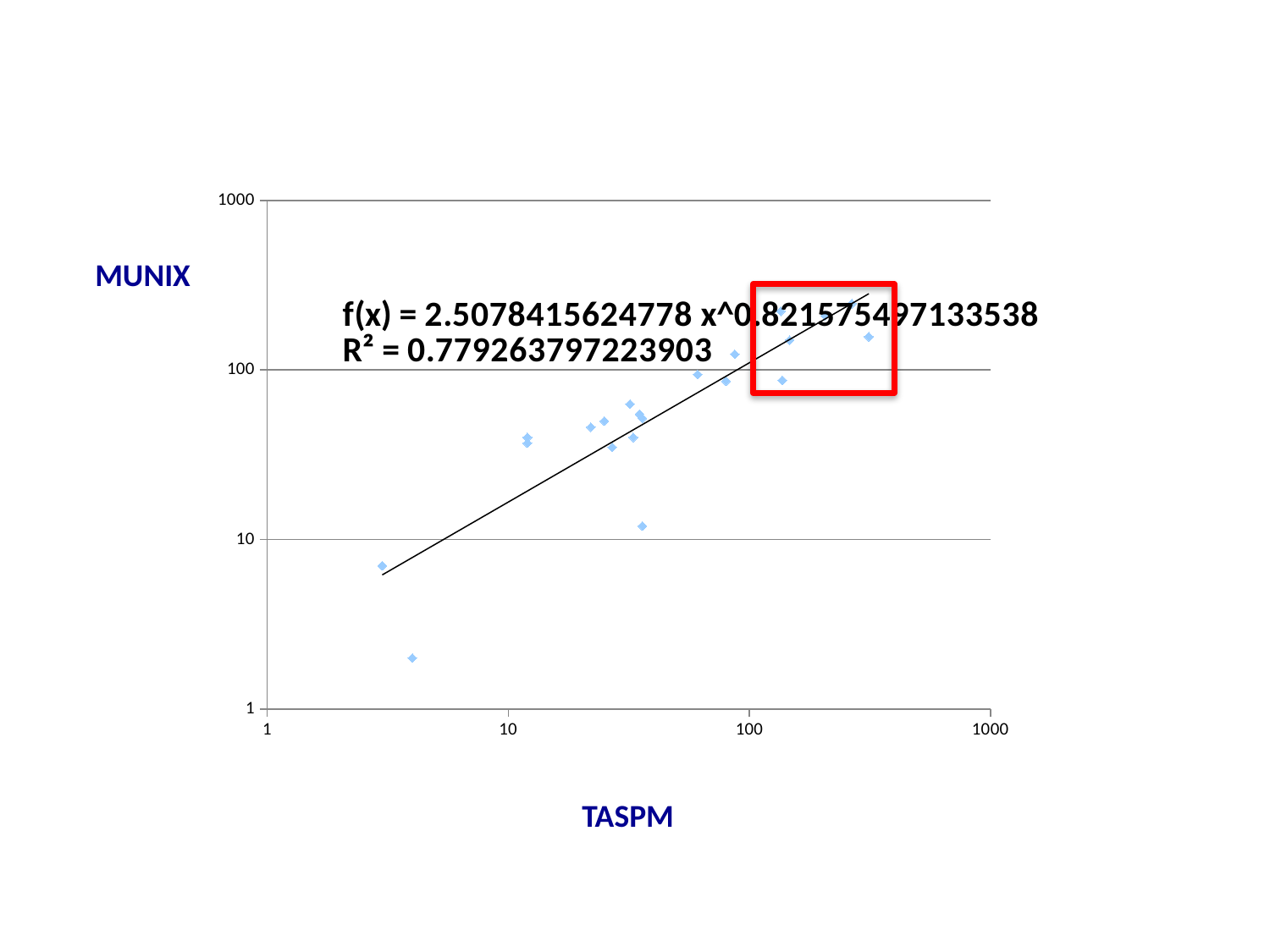
What kind of chart is shown on the slide? scatter plot Is the TASPM value of the rightmost point on the chart greater or less than 100? greater What is the R² value printed on the chart? 0.779263797223903 Is the MUNIX value of the highest point on the chart greater or less than 100? greater What label is shown on the horizontal axis of the chart? TASPM Is the TASPM value of the leftmost point on the chart greater or less than 10? less What is the coefficient (the number multiplying x) in the fitted equation f(x) shown on the chart? 2.5078415624778 What label is shown on the vertical axis of the chart? MUNIX Do the MUNIX values generally rise or fall as TASPM increases along the x axis? rise